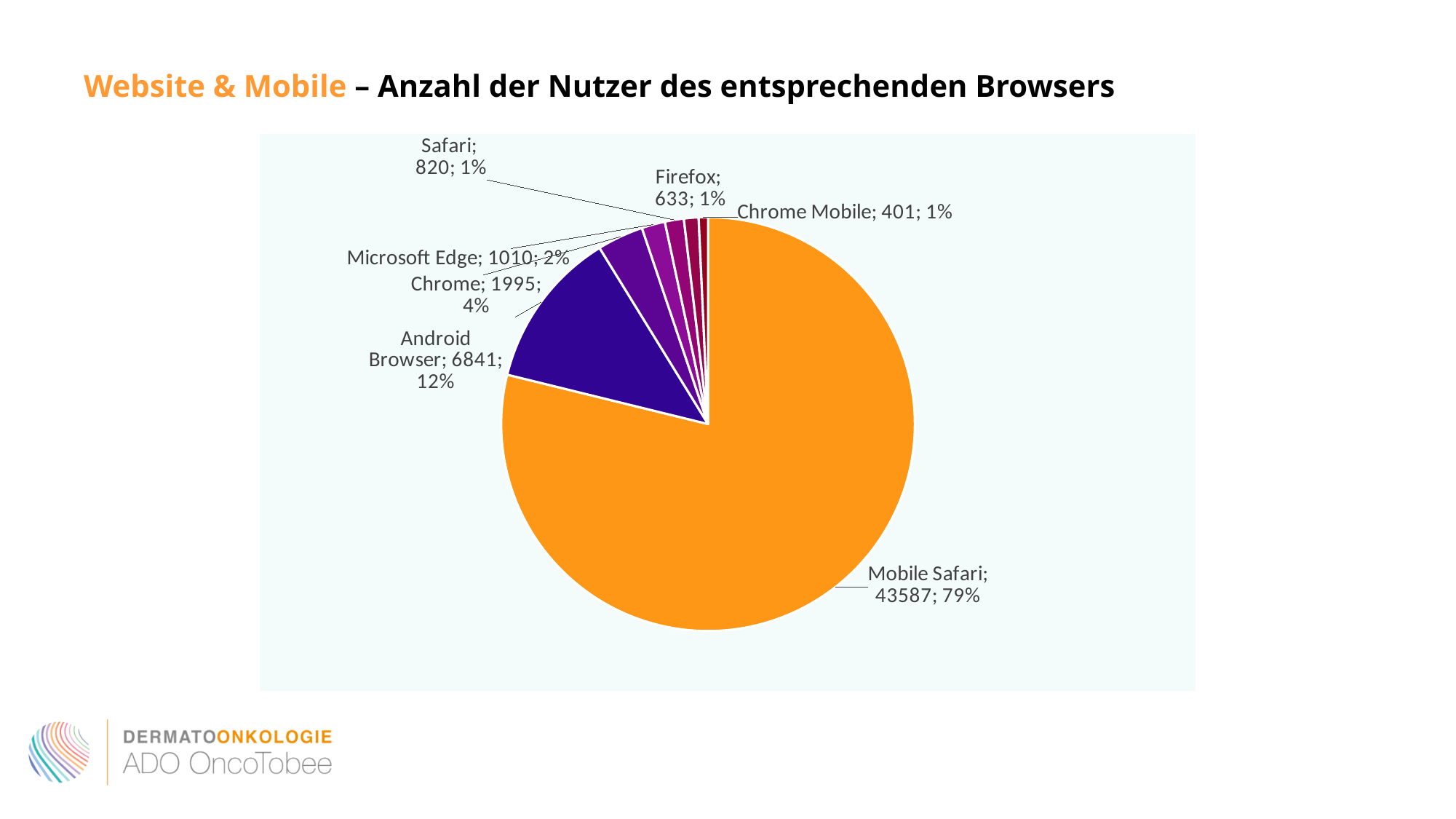
What share of the pie does Mobile Safari represent? 79% Which browser has the most users? Mobile Safari What share of the pie does Chrome represent? 4% What is the difference in users between Chrome and Microsoft Edge? 985 What type of chart is shown on the slide? pie chart What colour is the Mobile Safari slice? orange How many browser categories are shown in the pie chart? 7 Which has more users, Safari or Firefox? Safari How many users does Microsoft Edge have? 1010 Which browser has the fewest users? Chrome Mobile How many users does Mobile Safari have? 43587 How many users does Android Browser have? 6841